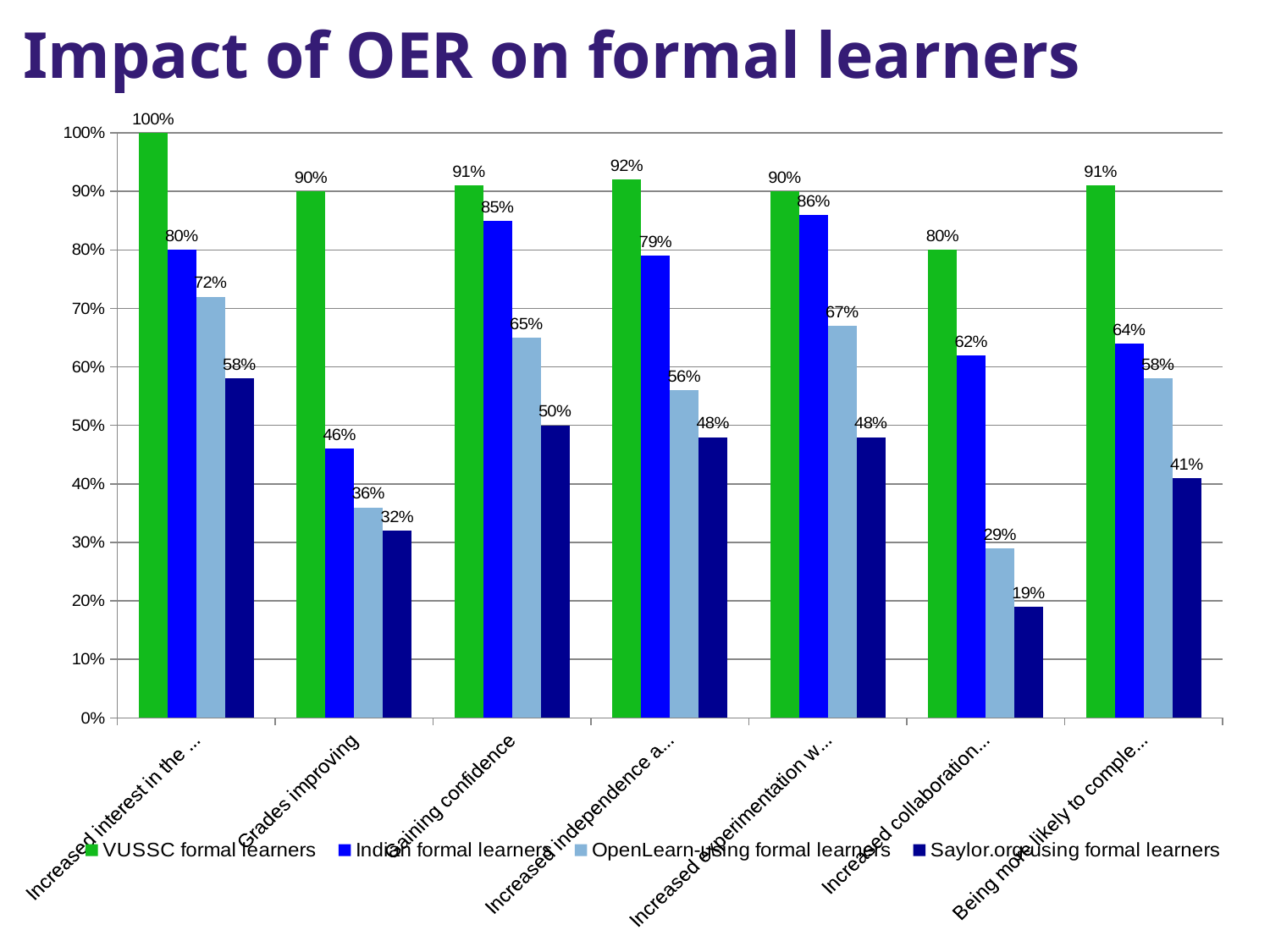
In the 'Increased independence' category, which is larger: the Indian formal learners value or the OpenLearn-using formal learners value? Indian formal learners Is the value for Indian formal learners in the 'Increased collaboration' category greater or less than 50%? greater How many series does the legend list? 4 What is the value for VUSSC formal learners in the 'Grades improving' category? 90% What is the difference between the VUSSC formal learners value and the Indian formal learners value in the 'Grades improving' category? 44% Which series has the lowest value in the 'Increased collaboration' category? Saylor.org-using formal learners How many categories are shown along the x axis? 7 What is the value for OpenLearn-using formal learners in the 'Increased experimentation' category? 67% Which series has the highest value in the 'Grades improving' category? VUSSC formal learners What type of chart is shown on the slide? Bar chart What is the value for Saylor.org-using formal learners in the 'Increased collaboration' category? 19% What is the title of the chart? Impact of OER on formal learners